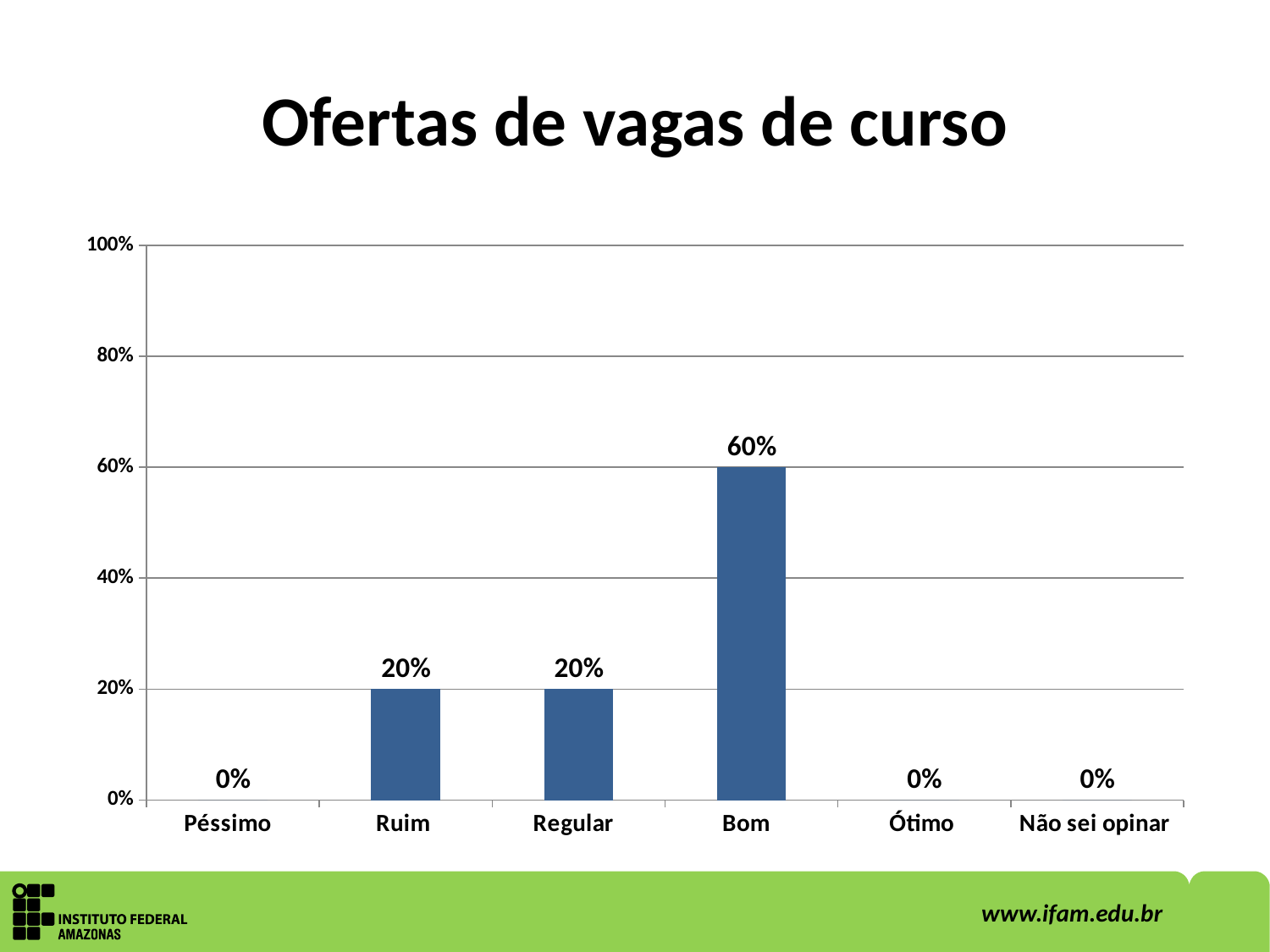
What kind of chart is shown on the slide? bar chart How many categories have a value of 0%? 3 Which category has the highest value? Bom What is the title of the chart? Ofertas de vagas de curso What is the value for Ruim? 20% What is the value for Péssimo? 0% How many categories are shown on the x axis? 6 What is the value for Não sei opinar? 0% Which is larger, the value for Bom or the value for Ruim? Bom Is the value for Bom greater or less than 40%? greater What is the difference between the values for Bom and Regular? 40% What is the value for Bom? 60%